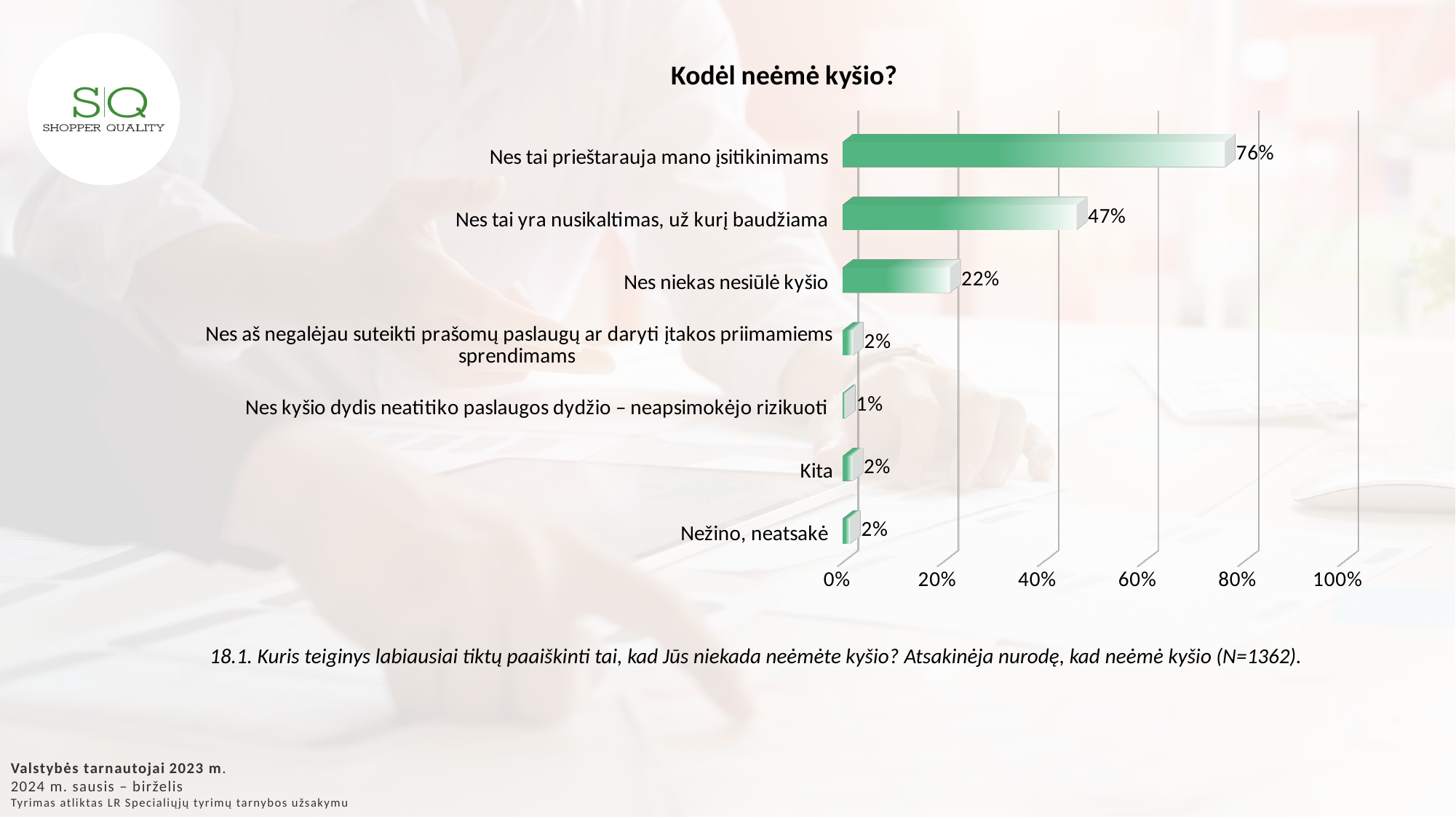
What is the value for "Nes niekas nesiūlė kyšio"? 22% How many categories are shown in the chart? 7 What is the title of the chart? Kodėl neėmė kyšio? Is the value for "Nes tai prieštarauja mano įsitikinimams" greater or less than 60%? greater What is the value for "Nes tai yra nusikaltimas, už kurį baudžiama"? 47% Which category has the highest value? Nes tai prieštarauja mano įsitikinimams What is the value for "Nes tai prieštarauja mano įsitikinimams"? 76% Which is larger: the value for "Nes tai yra nusikaltimas, už kurį baudžiama" or for "Nes niekas nesiūlė kyšio"? Nes tai yra nusikaltimas, už kurį baudžiama What kind of chart is shown on the slide? bar chart Which category has the lowest value? Nes kyšio dydis neatitiko paslaugos dydžio – neapsimokėjo rizikuoti What is the difference between the values for "Nes tai prieštarauja mano įsitikinimams" and "Nes tai yra nusikaltimas, už kurį baudžiama"? 29% What is the value for "Nes kyšio dydis neatitiko paslaugos dydžio – neapsimokėjo rizikuoti"? 1%